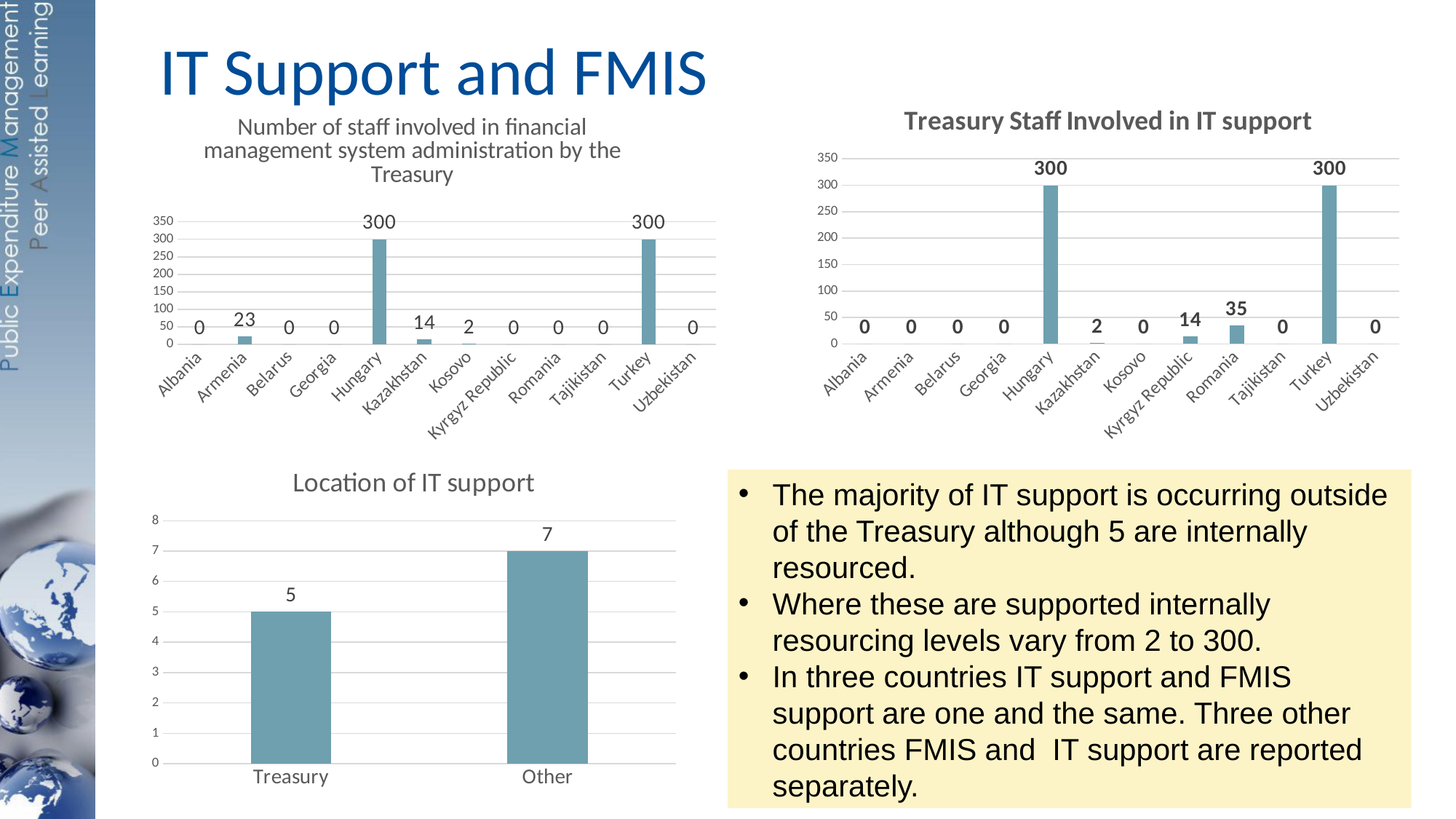
In the 'Number of staff involved in financial management system administration by the Treasury' chart, what is the value for Armenia? 23 What kind of chart is the 'Treasury Staff Involved in IT support' chart? Bar chart In the 'Number of staff involved in financial management system administration by the Treasury' chart, what is the difference between the values for Armenia and Kosovo? 21 In the 'Number of staff involved in financial management system administration by the Treasury' chart, what is the value for Kazakhstan? 14 In the 'Treasury Staff Involved in IT support' chart, what is the difference between the values for Romania and Kyrgyz Republic? 21 In the 'Treasury Staff Involved in IT support' chart, what is the value for Kyrgyz Republic? 14 In the 'Location of IT support' chart, what is the value for Treasury? 5 In the 'Location of IT support' chart, which category has the highest value? Other How many countries are shown in the 'Number of staff involved in financial management system administration by the Treasury' chart? 12 In the 'Location of IT support' chart, what is the total of the Treasury and Other values? 12 In the 'Treasury Staff Involved in IT support' chart, which is larger, the value for Romania or the value for Kazakhstan? Romania In the 'Treasury Staff Involved in IT support' chart, what is the value for Romania? 35